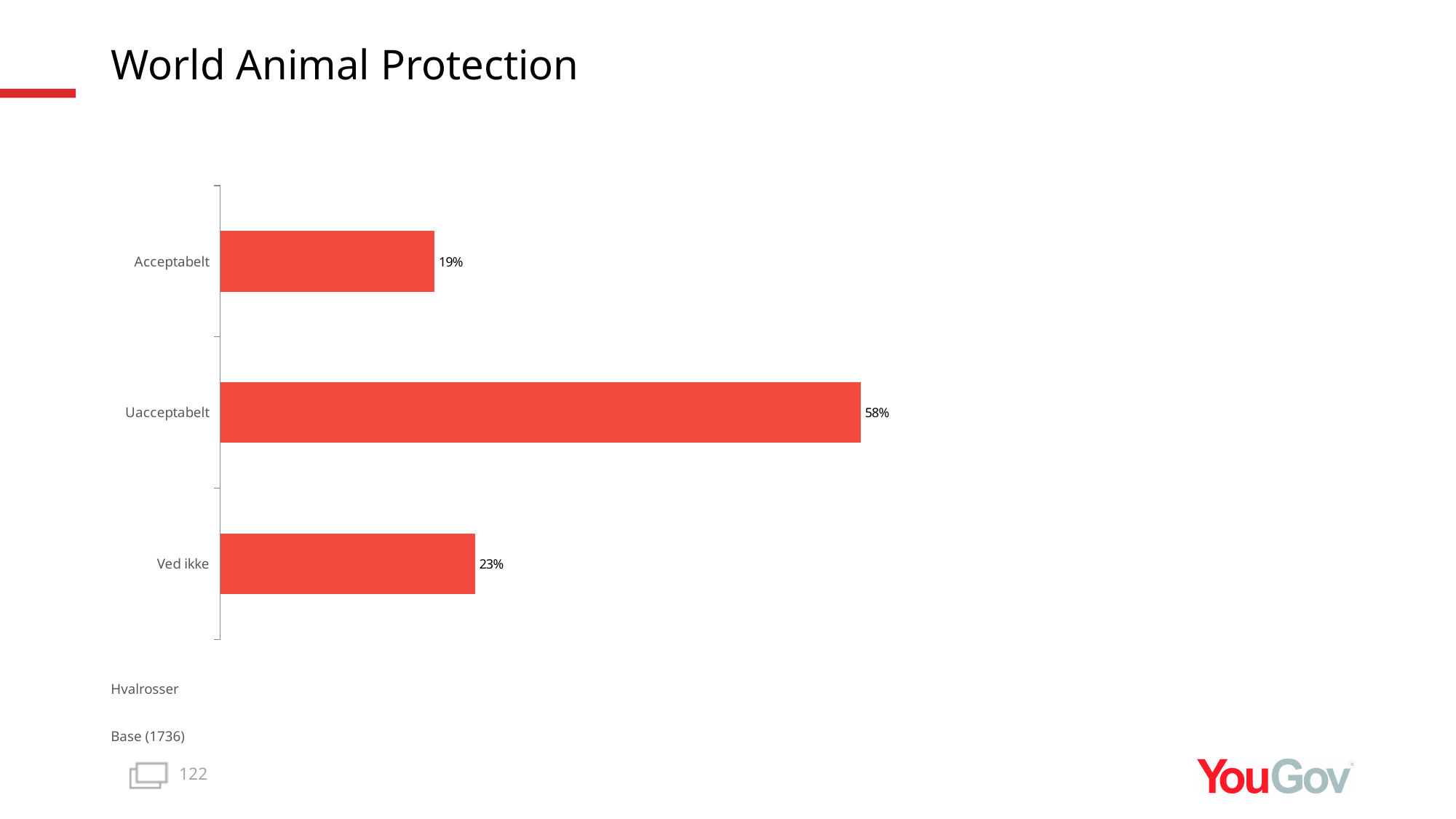
What percentage is shown for Acceptabelt? 19% What is the base (number of respondents) noted below the chart? 1736 Which category has the highest value? Uacceptabelt What percentage is shown for Ved ikke? 23% How many categories are shown in the chart? 3 What colour are the bars in the chart? Red What percentage is shown for Uacceptabelt? 58% What is the difference between the values for Uacceptabelt and Acceptabelt? 39 percentage points What is the difference between the values for Ved ikke and Acceptabelt? 4 percentage points What type of chart is shown on the slide? Bar chart Which is larger, the value for Ved ikke or the value for Acceptabelt? Ved ikke Which category has the lowest value? Acceptabelt